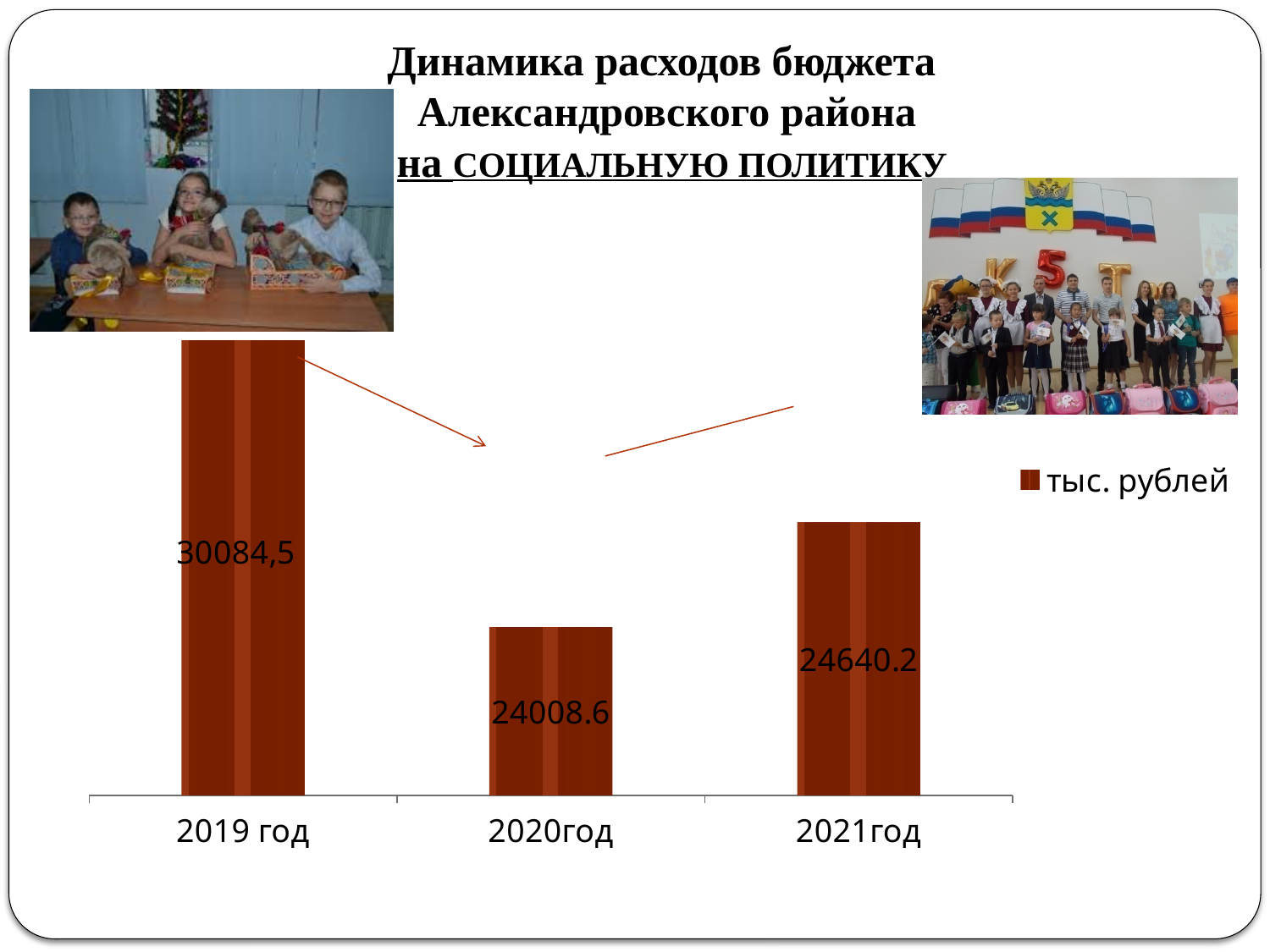
What is the value for 2020год? 24008.6 What kind of chart is shown on the slide? bar chart Which year has the highest value? 2019 год Which is larger, the value for 2021год or the value for 2020год? 2021год How many years are shown on the x axis? 3 Does the value rise or fall from 2019 год to 2020год? fall What is the difference between the values for 2021год and 2020год? 631.6 How many series does the legend list? 1 What is the value for 2019 год? 30084,5 What is the difference between the values for 2019 год and 2020год? 6075.9 Which year has the lowest value? 2020год What is the value for 2021год? 24640.2